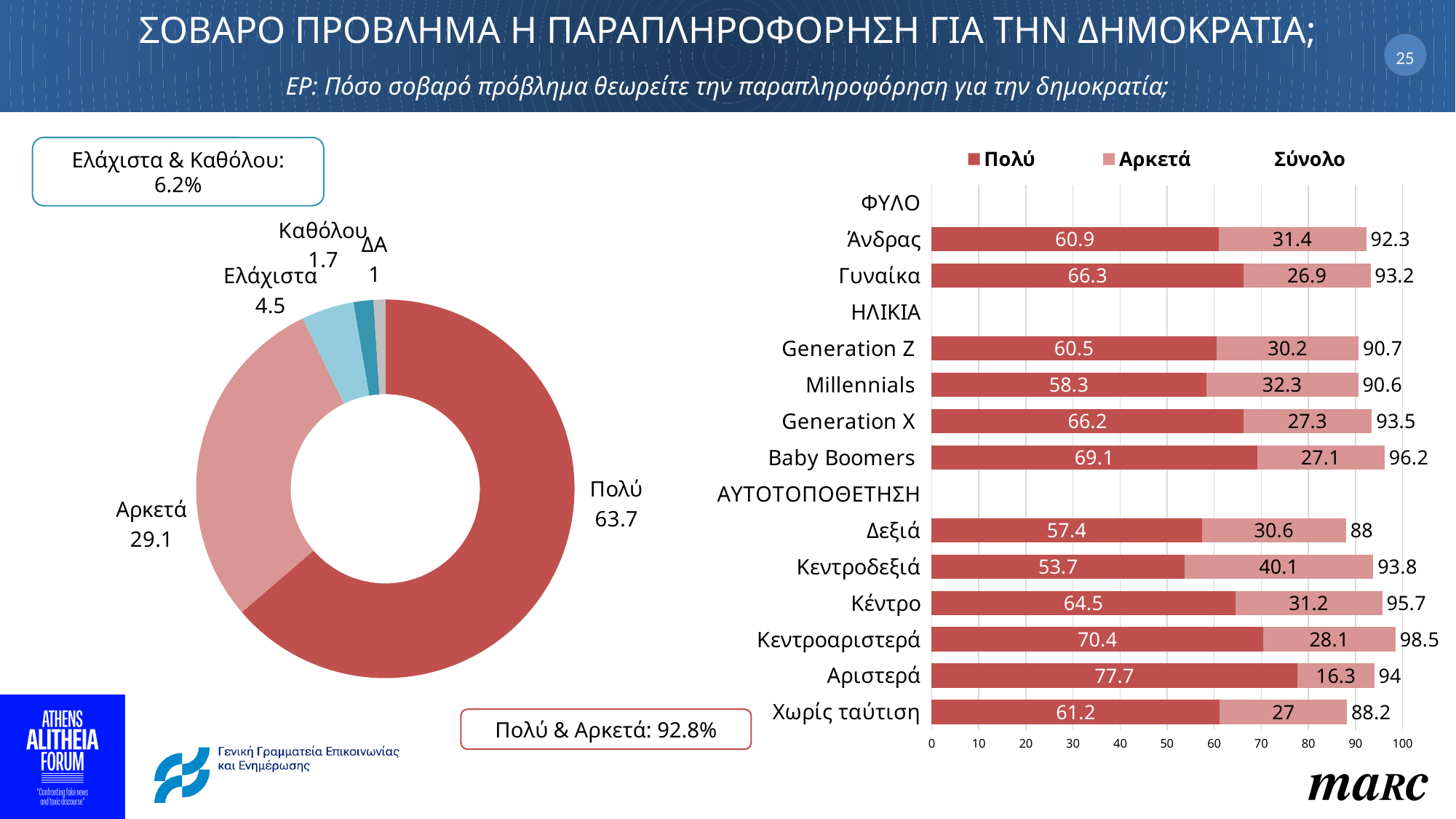
In the bar chart on the right, which has a larger Πολύ value, Άνδρας or Γυναίκα? Γυναίκα In the donut chart on the left, what is the value for Ελάχιστα? 4.5 In the bar chart on the right, what is the Σύνολο value for Baby Boomers? 96.2 In the donut chart on the left, what is the difference between Πολύ and Αρκετά? 34.6 In the bar chart on the right, what is the Αρκετά value for Κεντροδεξιά? 40.1 In the donut chart on the left, which category has the smallest value? ΔΑ In the donut chart on the left, what is the value for Πολύ? 63.7 In the bar chart on the right, which category has the highest Πολύ value? Αριστερά In the bar chart on the right, what is the Πολύ value for Αριστερά? 77.7 What type of chart is shown on the right side of the slide? Bar chart In the bar chart on the right, which category has the lowest Σύνολο value? Δεξιά In the bar chart on the right, how many categories have bars plotted? 12